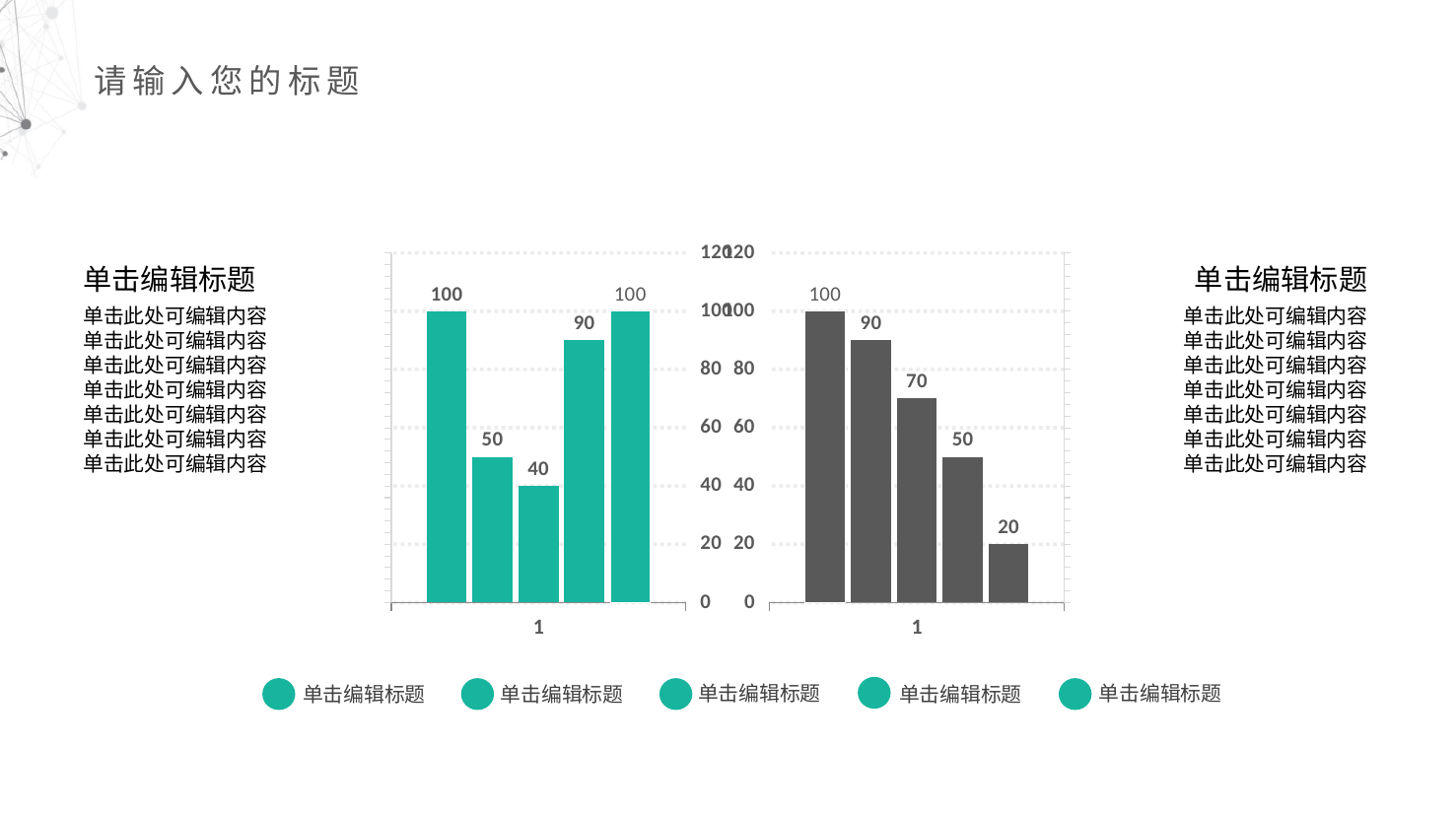
In the right chart, what is the value of the last (rightmost) bar? 20 In the right chart, is the second bar larger or smaller than the fourth bar? Larger What type of chart is the left chart? Bar chart In the left chart, what is the value of the first (leftmost) bar? 100 In the right chart, which bar has the highest value? The first bar (100) In the right chart, what is the value of the third bar? 70 In the right chart, what is the difference between the first bar and the last bar? 80 In the left chart, what is the value of the third bar? 40 In the left chart, which bar has the lowest value? The third bar (40) How many bars are plotted in the right chart? 5 In the right chart, do the bar values rise or fall from left to right? Fall In the left chart, what is the difference between the fourth bar and the second bar? 40